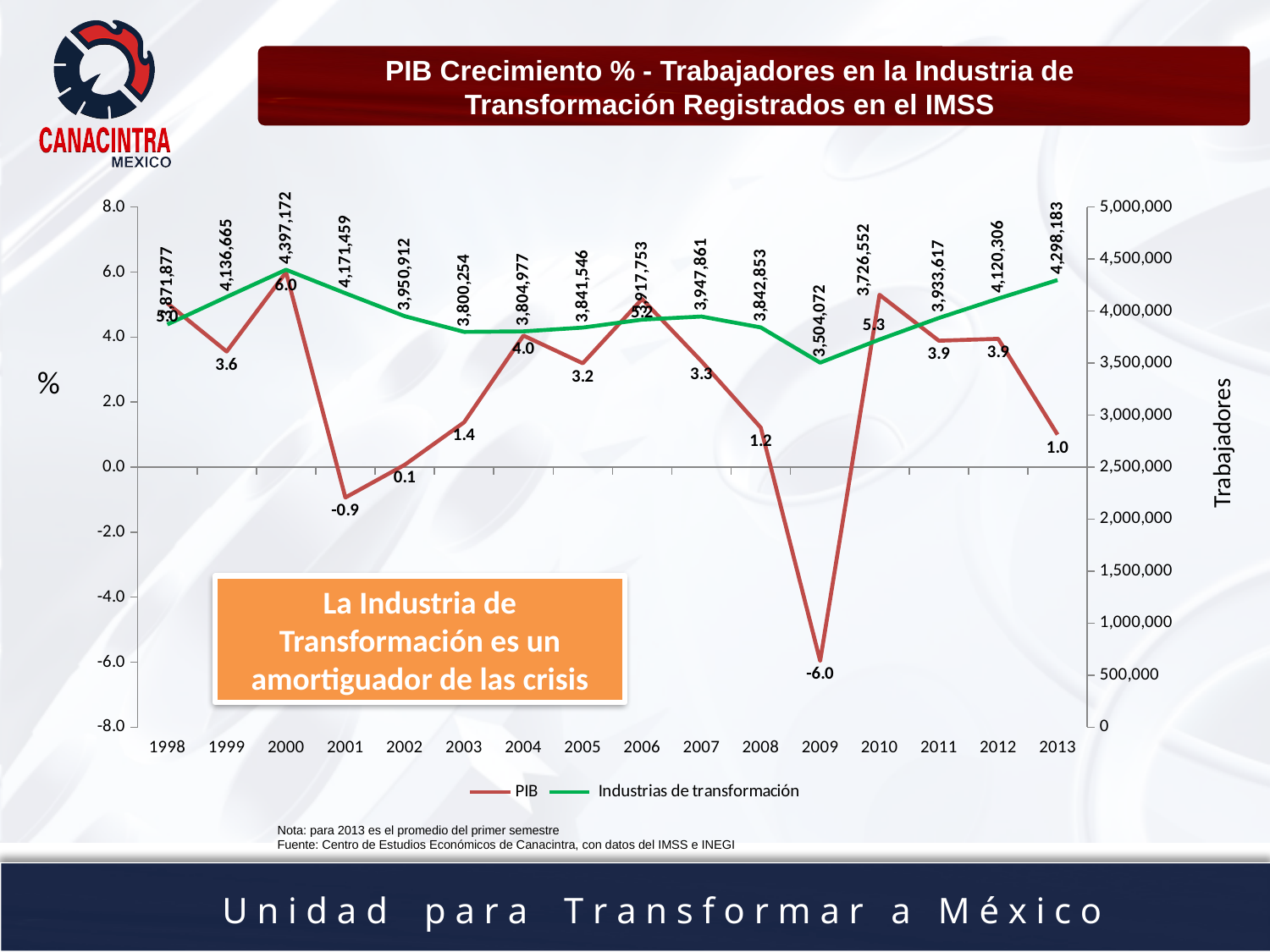
By how much did PIB growth change from 2009 to 2010? 11.3 Which year has the higher PIB growth, 2010 or 2011? 2010 What is the difference between the Industrias de transformación values for 2013 and 2012? 177,877 What is the PIB growth value for 2001? -0.9 In which year is the Industrias de transformación series lowest? 2009 What is the PIB growth value for 2009? -6.0 In which year is the Industrias de transformación series highest? 2000 How many series does the legend list? 2 How many workers does the Industrias de transformación series show for 2013? 4,298,183 In which year is the PIB growth lowest? 2009 How many years are plotted on the x axis? 16 What kind of chart is shown on the slide? Line chart